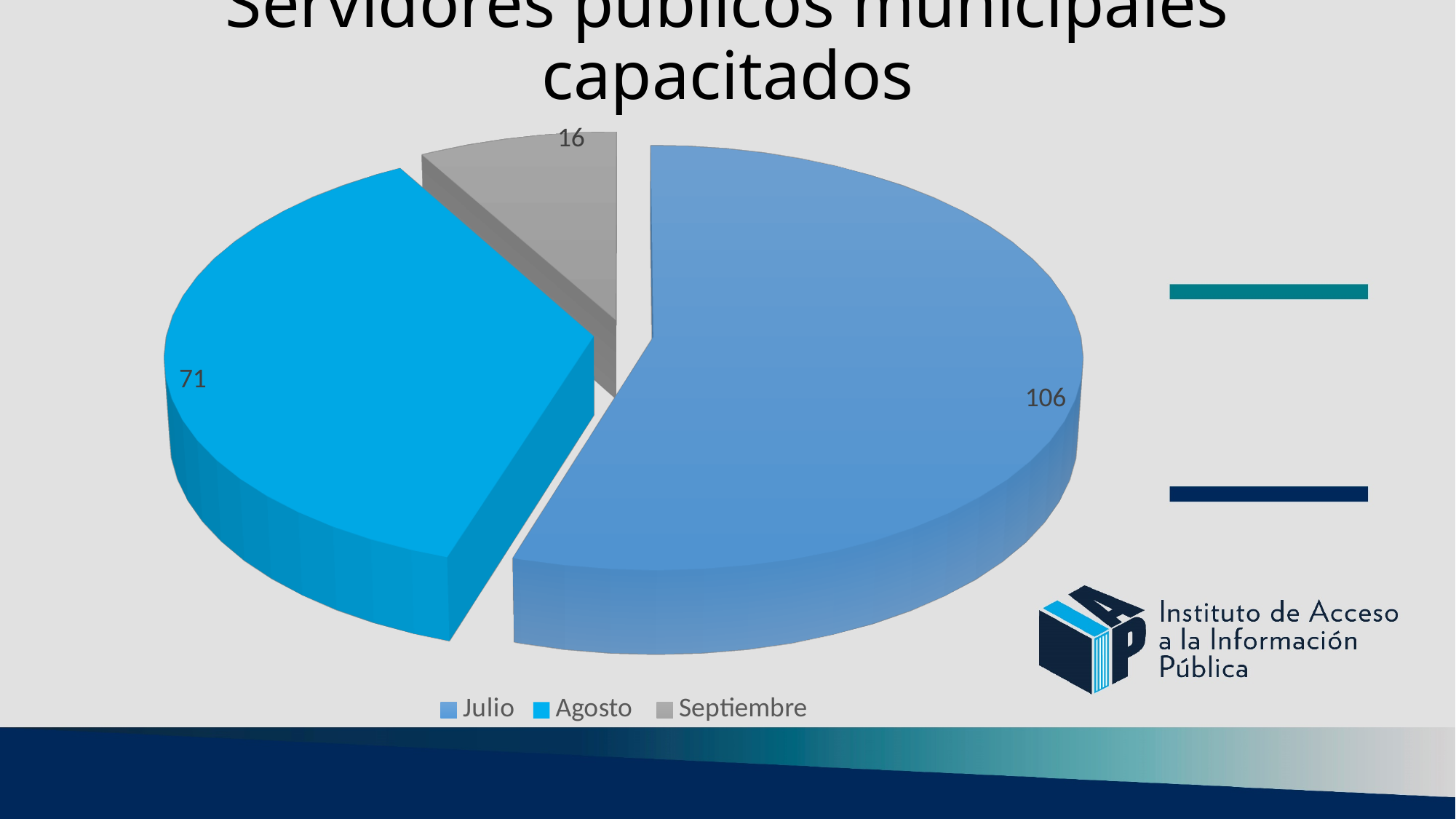
How many slices does the pie chart have? 3 What is the difference between the values for Julio and Agosto? 35 Which month has the largest slice in the pie chart? Julio Which month has the smallest slice in the pie chart? Septiembre What is the total of all three slices in the pie chart? 193 What is the title of the chart? Servidores públicos municipales capacitados What is the value for Agosto in the pie chart? 71 Which is larger, the value for Agosto or the value for Septiembre? Agosto What is the value for Julio in the pie chart? 106 What is the difference between the values for Agosto and Septiembre? 55 What is the value for Septiembre in the pie chart? 16 What type of chart is shown on the slide? pie chart